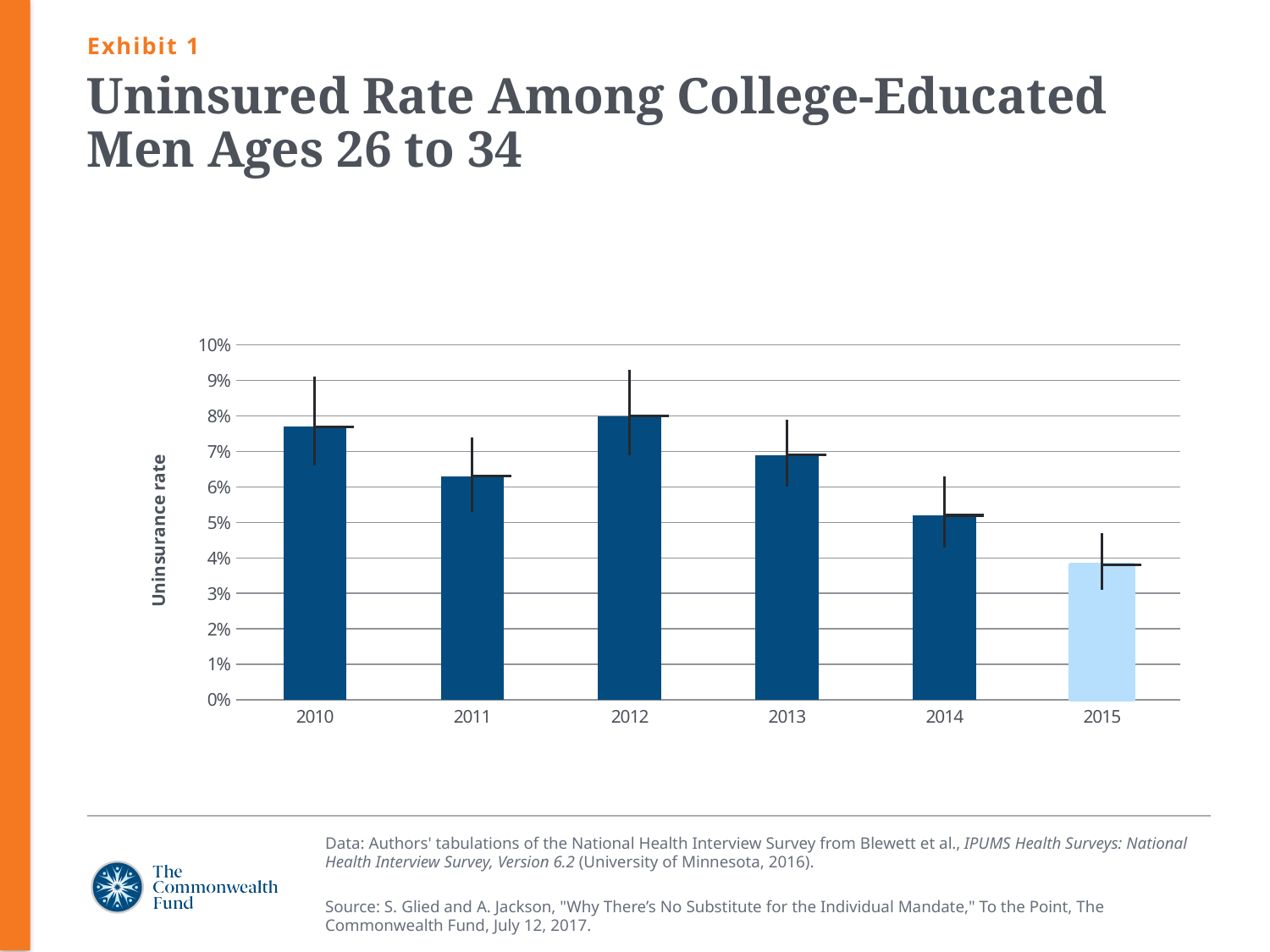
Is the uninsurance rate for 2014 greater or less than 5%? greater Which year has the lowest uninsurance rate? 2015 Is the uninsurance rate for 2015 greater or less than 4%? less What is the label on the vertical axis of the chart? Uninsurance rate Is the uninsurance rate for 2013 greater or less than 6%? greater Which year has the higher uninsurance rate, 2010 or 2011? 2010 How many years are shown on the x axis of the chart? 6 Does the uninsurance rate generally rise or fall from 2012 to 2015? fall What kind of chart is shown on the slide? bar chart Which year has the higher uninsurance rate, 2013 or 2014? 2013